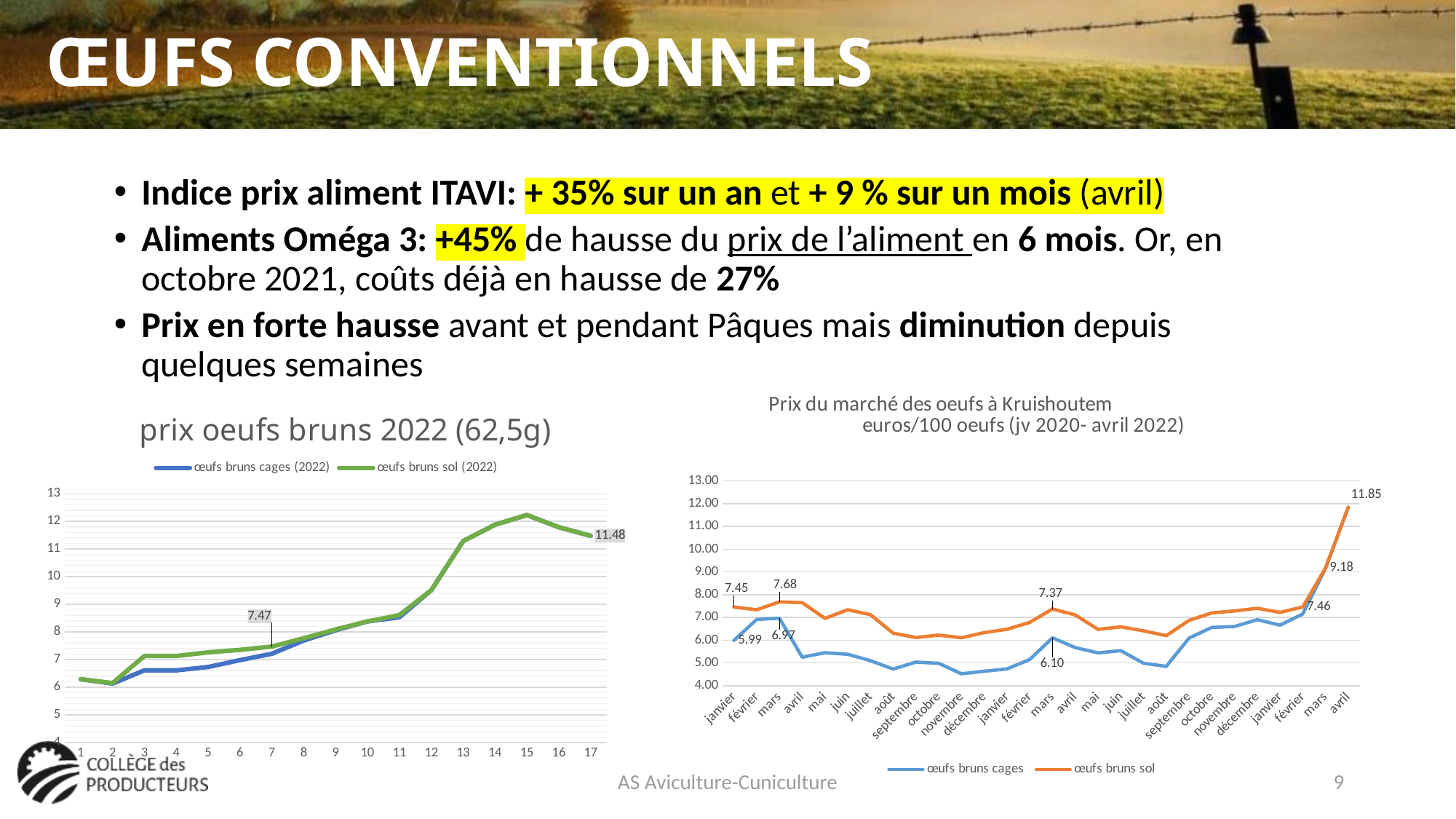
On the chart 'Prix du marché des oeufs à Kruishoutem', which series is higher in avril 2022, œufs bruns cages or œufs bruns sol? Neither; both are equal at 11.85 On the chart 'Prix du marché des oeufs à Kruishoutem', what is the difference between œufs bruns sol and œufs bruns cages in avril 2022? 0.00 On the chart 'Prix du marché des oeufs à Kruishoutem', in which month does the œufs bruns sol series reach its highest value? avril 2022 On the chart 'Prix du marché des oeufs à Kruishoutem', what is the value for œufs bruns cages in avril 2022? 11.85 On the chart 'prix oeufs bruns 2022 (62,5g)', what is the value labelled at point 7? 7.47 How many points are on the x axis of the chart 'prix oeufs bruns 2022 (62,5g)'? 17 How many series does the legend of the chart 'Prix du marché des oeufs à Kruishoutem' list? 2 On the chart 'prix oeufs bruns 2022 (62,5g)', what is the value labelled at point 17? 11.48 On the chart 'Prix du marché des oeufs à Kruishoutem', is the value for œufs bruns cages in décembre 2020 greater or less than 5.00? less On the chart 'Prix du marché des oeufs à Kruishoutem', what is the value for œufs bruns sol in avril 2022? 11.85 What kind of chart is 'prix oeufs bruns 2022 (62,5g)'? line chart On the chart 'Prix du marché des oeufs à Kruishoutem', what is the difference between œufs bruns sol (7.68) and œufs bruns cages (6.97) in mars 2020? 0.71